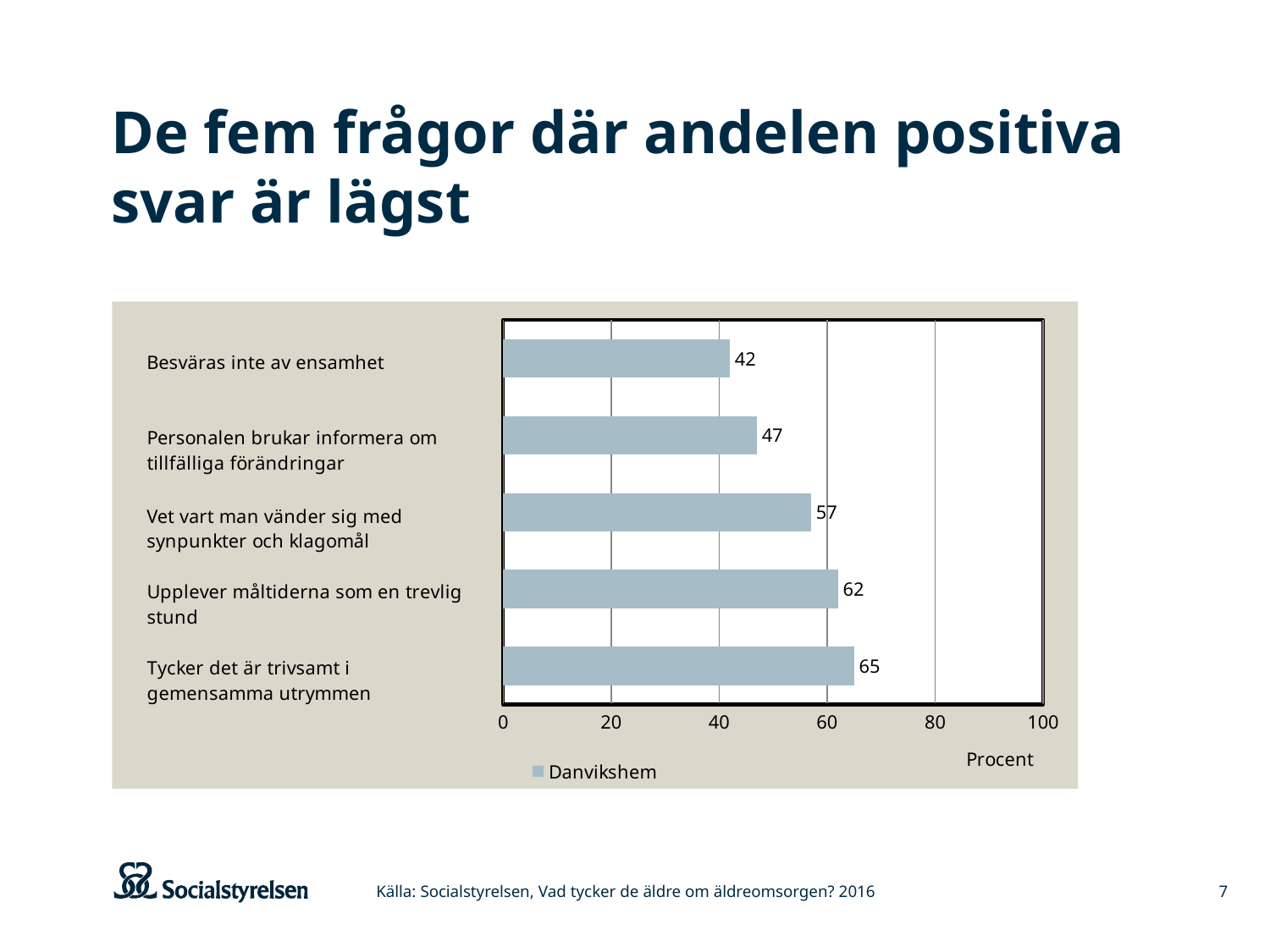
How many categories are shown in the chart? 5 Which is larger: the value for "Vet vart man vänder sig med synpunkter och klagomål" or the value for "Personalen brukar informera om tillfälliga förändringar"? Vet vart man vänder sig med synpunkter och klagomål What is the value for "Besväras inte av ensamhet"? 42 What kind of chart is shown on the slide? bar chart Which category has the lowest value? Besväras inte av ensamhet What is the value for "Personalen brukar informera om tillfälliga förändringar"? 47 What series name does the legend show? Danvikshem Which category has the highest value? Tycker det är trivsamt i gemensamma utrymmen What is the difference between the values for "Upplever måltiderna som en trevlig stund" and "Besväras inte av ensamhet"? 20 Is the value for "Upplever måltiderna som en trevlig stund" greater or less than 80? less What is the value for "Tycker det är trivsamt i gemensamma utrymmen"? 65 What is the value for "Vet vart man vänder sig med synpunkter och klagomål"? 57